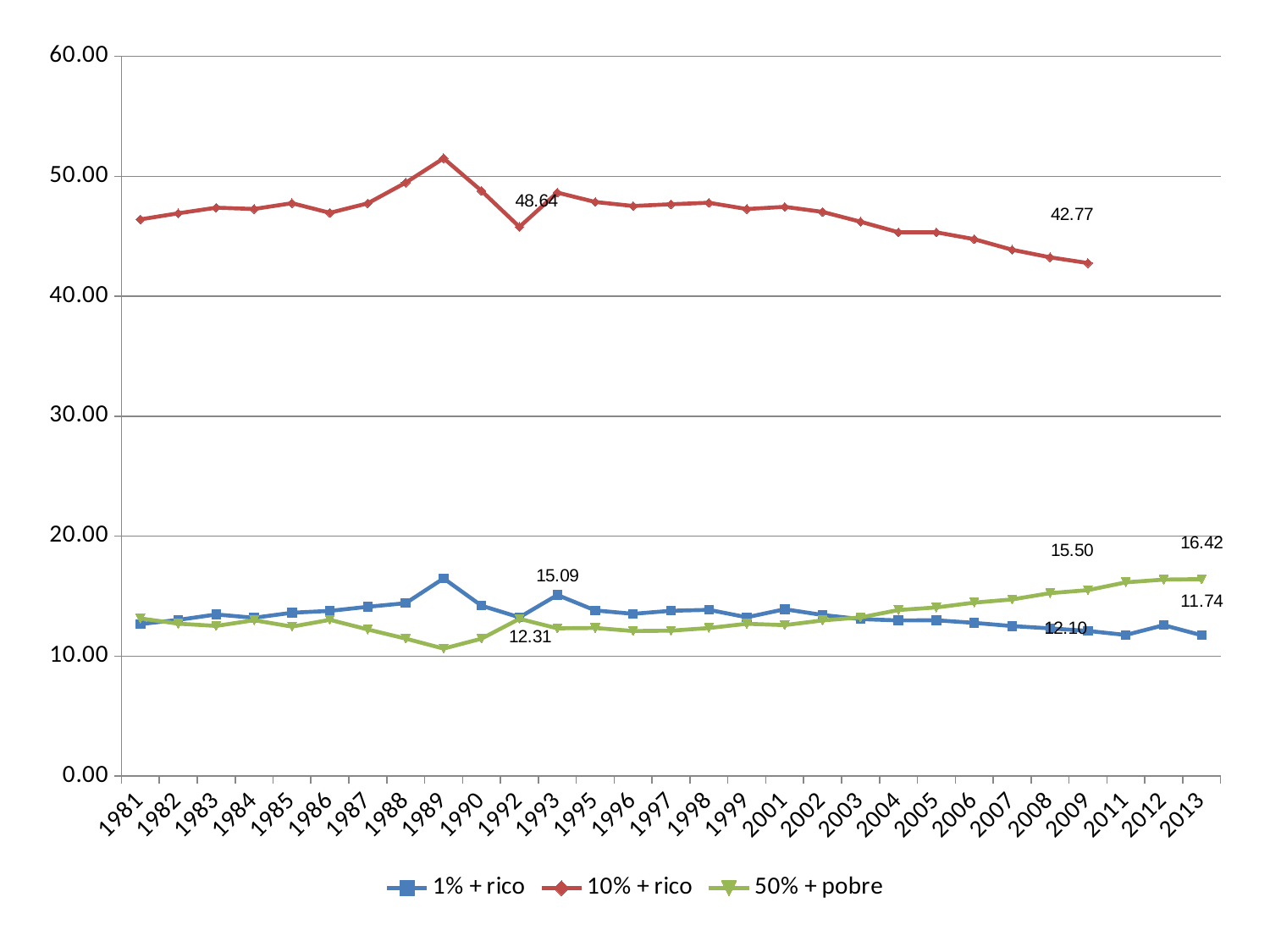
What is the value for the 10% + rico series in 1993? 48.64 What is the value for the 1% + rico series in 1993? 15.09 Is the value for the 10% + rico series in 1989 greater or less than 50? greater What is the difference between the 50% + pobre value and the 1% + rico value in 2013? 4.68 What is the value for the 1% + rico series in 2013? 11.74 How many years are shown on the x axis? 29 In 2013, which series has the larger value, 50% + pobre or 1% + rico? 50% + pobre How many series does the legend list? 3 What kind of chart is shown on the slide? line chart In which year does the 10% + rico series reach its highest value? 1989 Does the 50% + pobre series rise or fall from 2003 to 2013? rise What is the value for the 50% + pobre series in 2013? 16.42